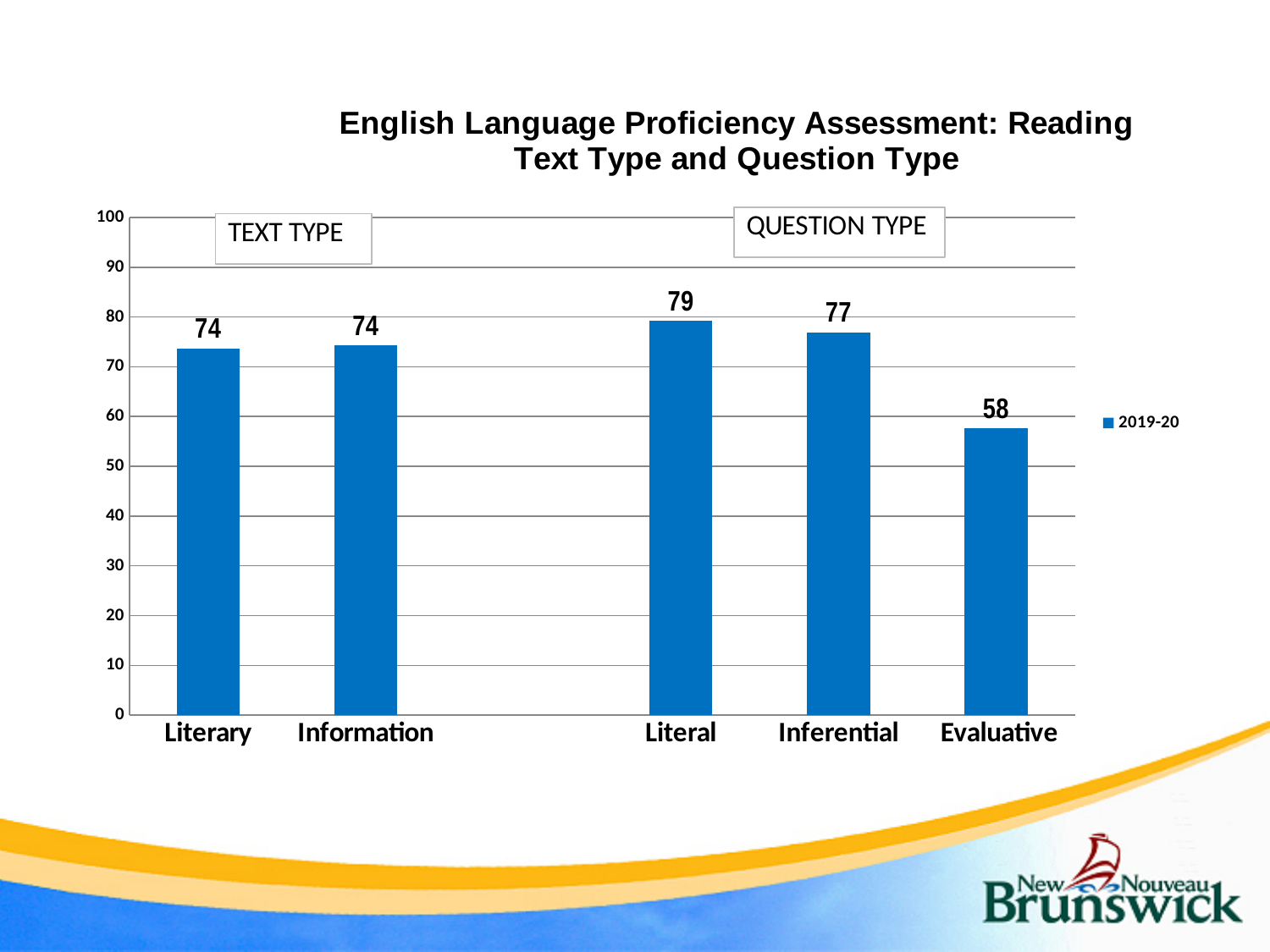
Which category has the highest value? Literal What kind of chart is shown? bar chart How many series does the legend list? 1 Is the value for Evaluative greater or less than 60? less What is the value for Inferential? 77 Which is larger, the value for Inferential or the value for Information? Inferential What series name is shown in the legend? 2019-20 What is the value for Evaluative? 58 What is the difference between the values for Literal and Evaluative? 21 What is the value for Literary? 74 How many categories are shown on the x axis? 5 Which category has the lowest value? Evaluative